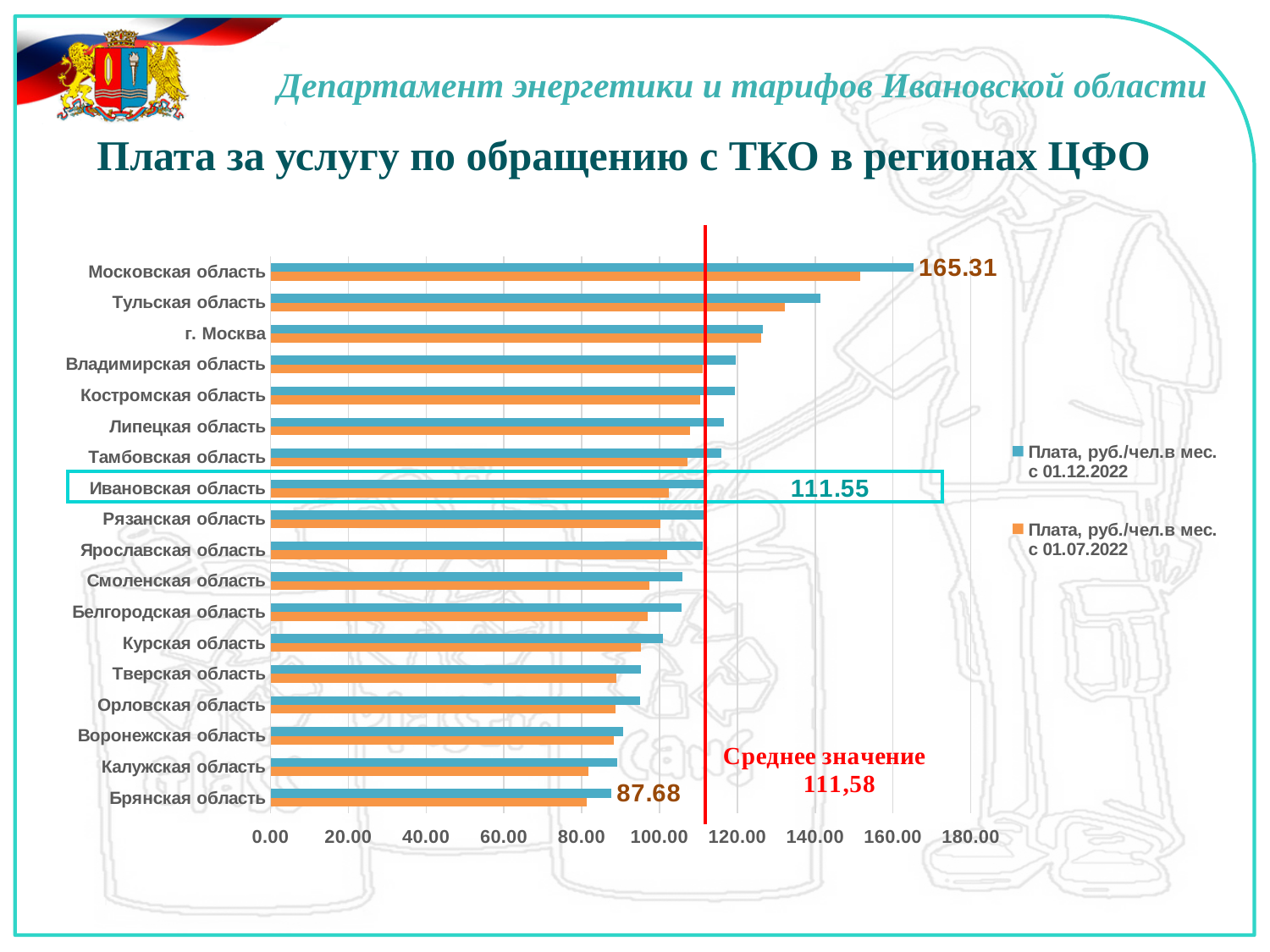
What is the value for Брянская область in the 'Плата, руб./чел.в мес. с 01.12.2022' series? 87.68 What is the average value (Среднее значение) marked by the red line on the chart? 111,58 Which region has the lowest value in the 'Плата, руб./чел.в мес. с 01.12.2022' series? Брянская область Which region has the highest value in the chart? Московская область What is the value for Московская область in the 'Плата, руб./чел.в мес. с 01.12.2022' series? 165.31 Is the value for Калужская область in the 'с 01.07.2022' series greater or less than 100? less How many series does the legend list? 2 What is the value for Ивановская область in the 'Плата, руб./чел.в мес. с 01.12.2022' series? 111.55 What is the difference between the 01.12.2022 values for Московская область and Ивановская область? 53.76 How many regions are shown in the chart? 18 Is the value for Московская область in the 'с 01.07.2022' series greater or less than 140? greater What is the difference between the 01.12.2022 values for Ивановская область and Брянская область? 23.87